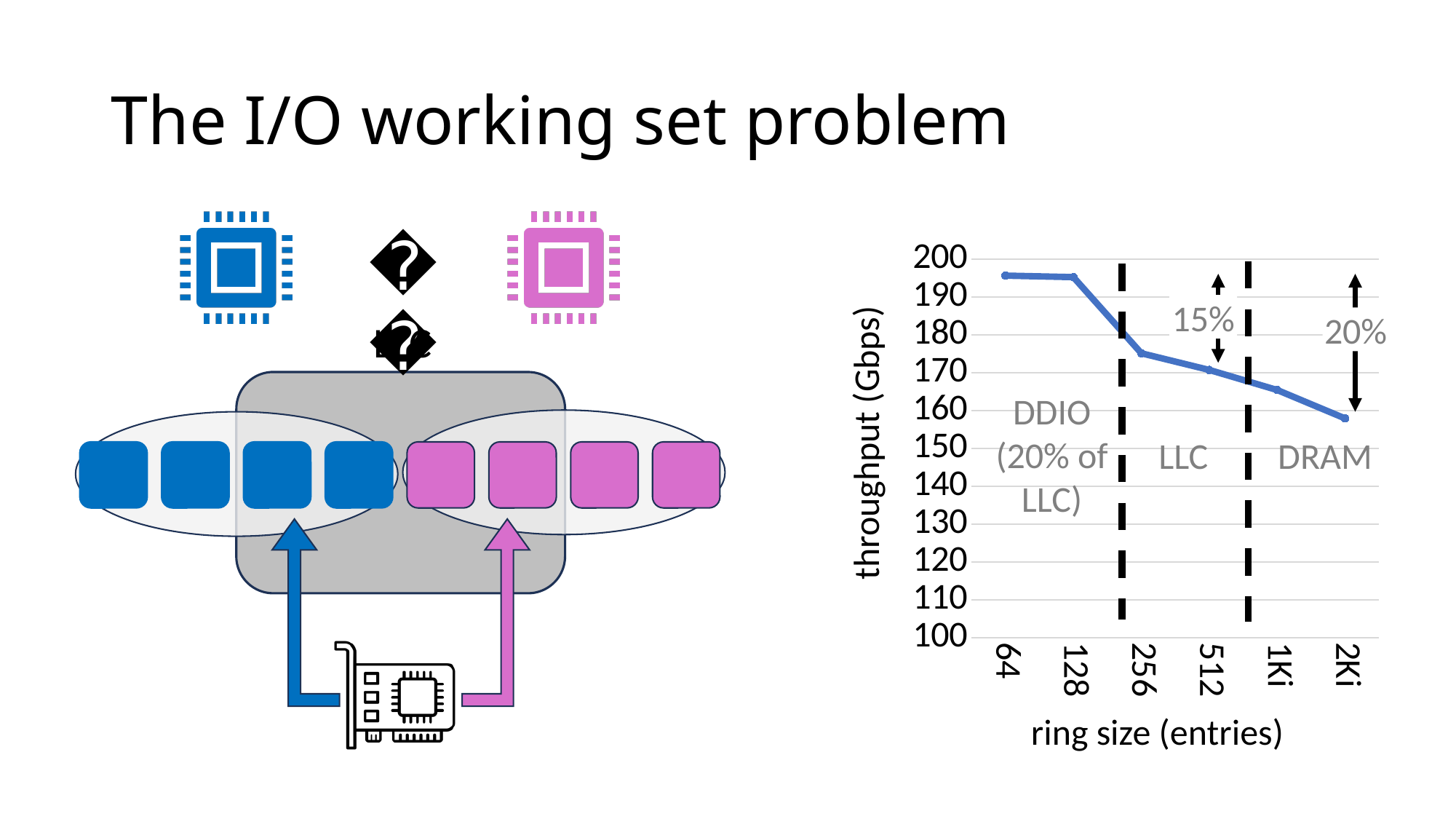
Is the throughput for a ring size of 2Ki greater or less than 160 Gbps? less Does throughput rise or fall as ring size increases along the x axis? fall Which has higher throughput: a ring size of 128 or a ring size of 1Ki? 128 What percentage drop is annotated in the DRAM region of the chart? 20% How many ring size values are plotted along the x axis of the chart? 6 Which has higher throughput: a ring size of 256 or a ring size of 2Ki? 256 What kind of chart is shown on the right of the slide? line chart Is the throughput for a ring size of 256 greater or less than 180 Gbps? less Is the throughput for a ring size of 64 greater or less than 190 Gbps? greater Which ring size has the lowest throughput in the chart? 2Ki What is the label of the y axis of the chart? throughput (Gbps)